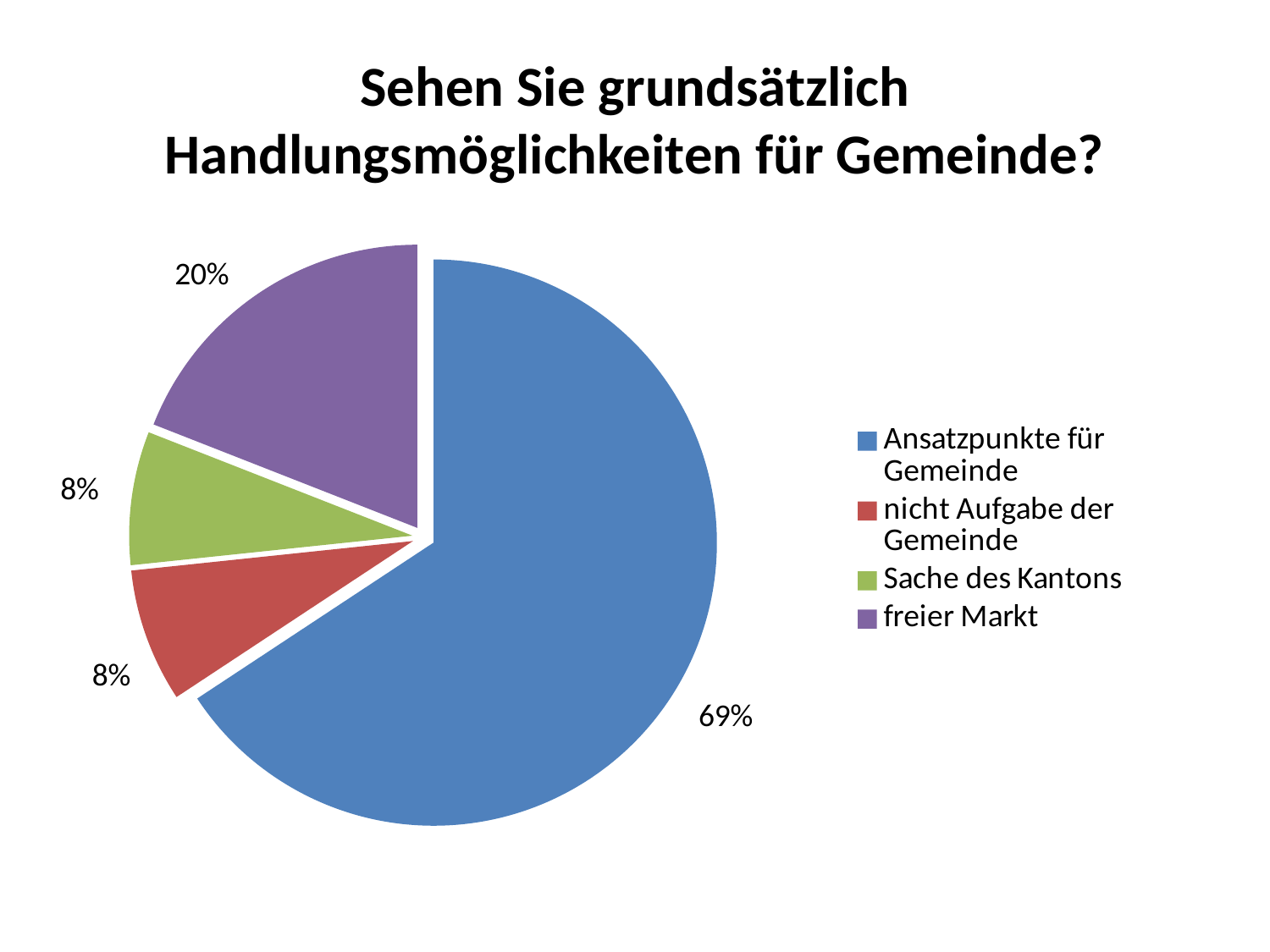
Which category has the largest slice of the pie? Ansatzpunkte für Gemeinde What share of the pie does "Ansatzpunkte für Gemeinde" have? 69% How many categories does the pie chart show? 4 What is the difference in percentage points between "Ansatzpunkte für Gemeinde" and "freier Markt"? 49 What share of the pie does "nicht Aufgabe der Gemeinde" have? 8% What kind of chart is shown on the slide? Pie chart Which colour represents "Sache des Kantons" in the legend? Green What share of the pie does "Sache des Kantons" have? 8% What is the title of the chart? Sehen Sie grundsätzlich Handlungsmöglichkeiten für Gemeinde? Which is larger, the slice for "freier Markt" or the slice for "Sache des Kantons"? freier Markt What is the difference in percentage points between "freier Markt" and "nicht Aufgabe der Gemeinde"? 12